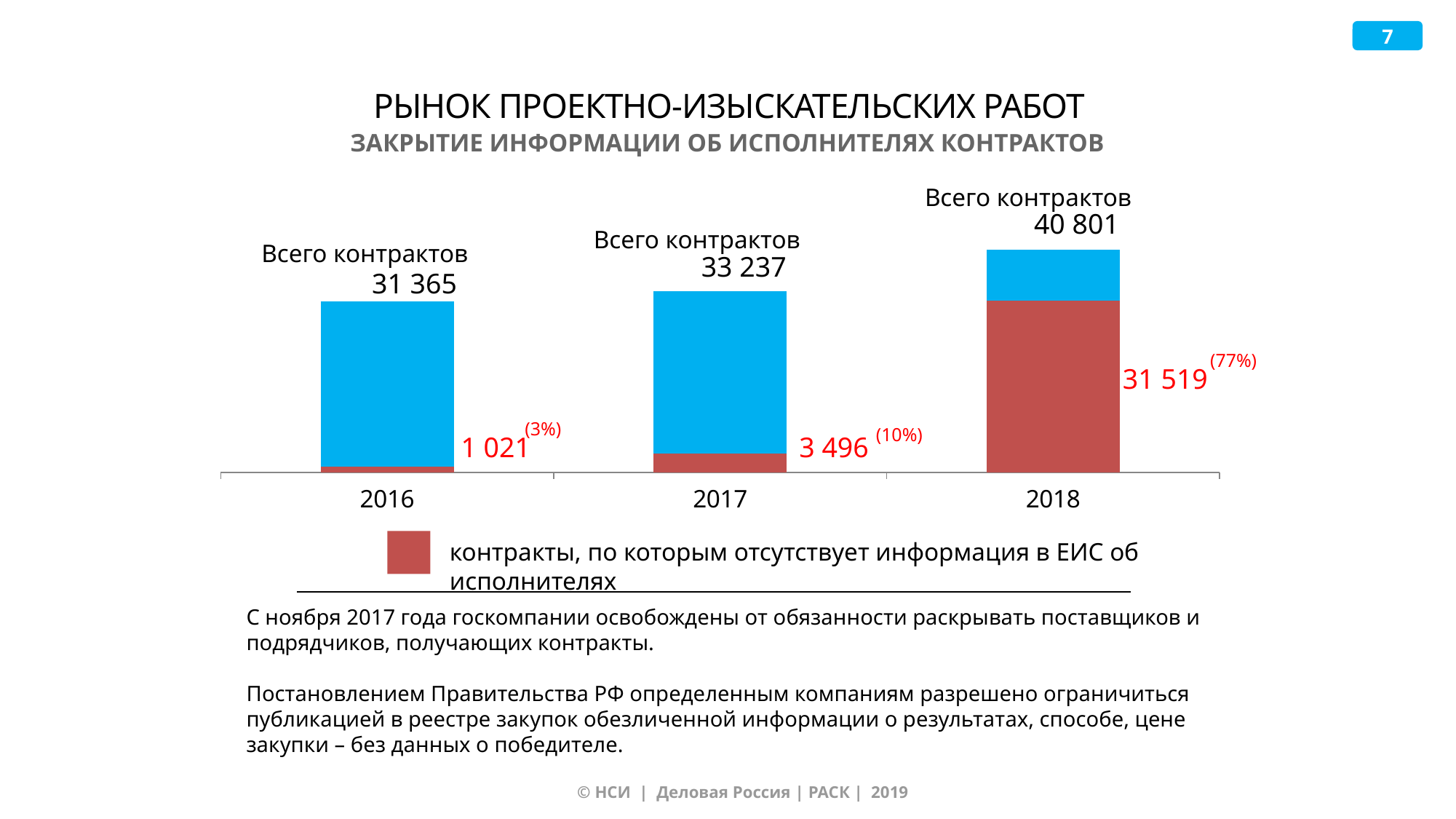
How many contracts with no information about executors in ЕИС are shown for 2018? 31 519 How many contracts with no information about executors in ЕИС are shown for 2017? 3 496 Does the number of contracts with missing executor information rise or fall from 2016 to 2018? rise By how much did the total number of contracts in 2018 exceed the total in 2016? 9 436 Which is larger: the total number of contracts in 2017 or in 2016? 2017 What is the total number of contracts (Всего контрактов) shown for 2018? 40 801 What share of all contracts in 2018 had no executor information in ЕИС, according to the label? 77% What is the difference between the number of contracts with missing executor information in 2018 and in 2017? 28 023 Which year has the lowest number of contracts with missing executor information? 2016 Which year has the highest total number of contracts? 2018 What is the total number of contracts shown for 2016? 31 365 How many years are shown on the x axis of the chart? 3